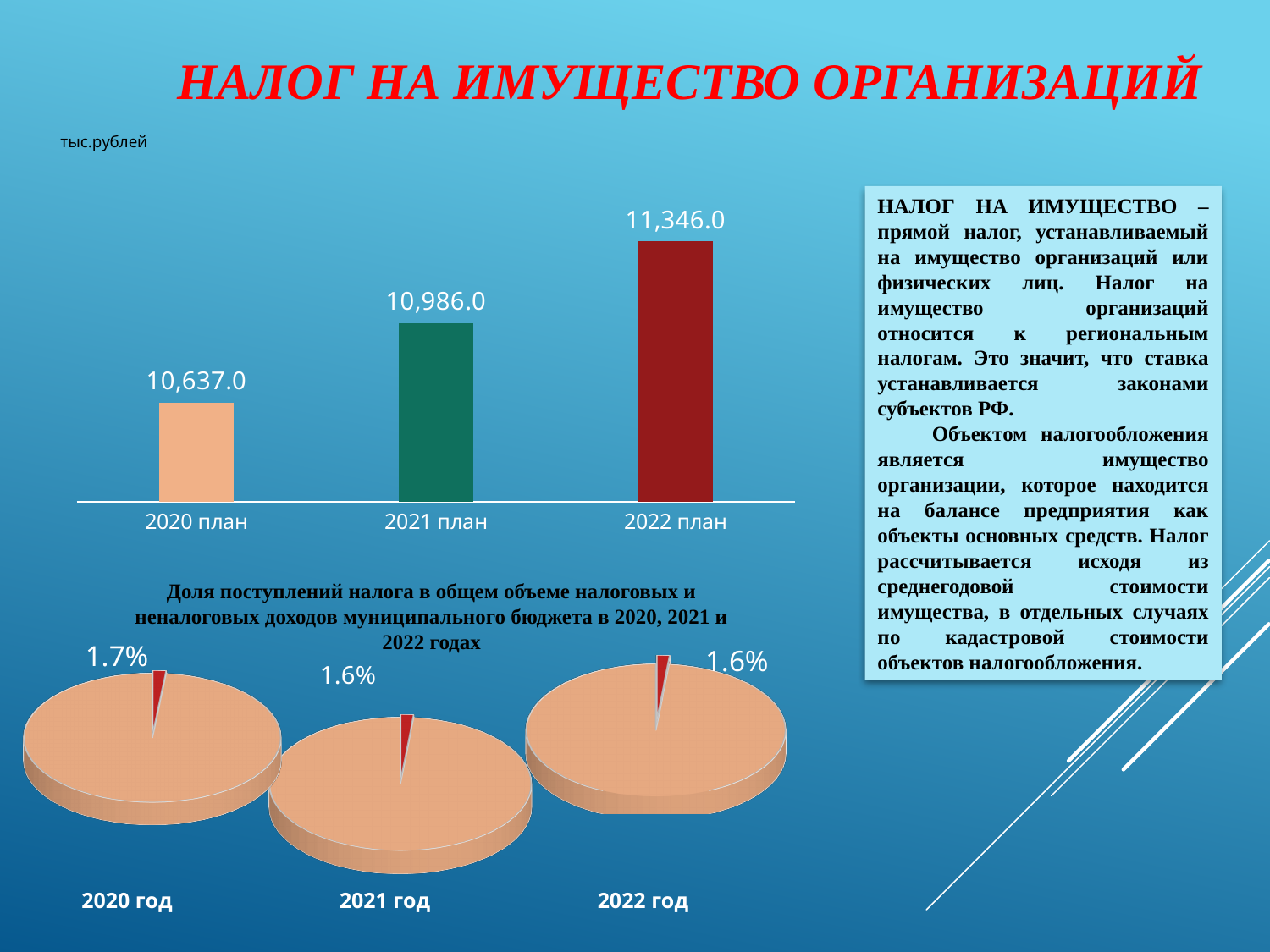
In the bar chart at the top of the slide, what is the value for 2021 план? 10,986.0 How many bars are shown in the bar chart at the top of the slide? 3 In the bar chart at the top of the slide, which is larger: the value for 2021 план or 2022 план? 2022 план In the bar chart at the top of the slide, what is the difference between the values for 2021 план and 2020 план? 349.0 In the bar chart at the top of the slide, what is the value for 2020 план? 10,637.0 In the pie charts at the bottom of the slide, what share is shown for 2020 год? 1.7% In the bar chart at the top of the slide, what is the value for 2022 план? 11,346.0 In the bar chart at the top of the slide, which category has the lowest value? 2020 план What unit is stated for the bar chart at the top of the slide? тыс.рублей In the bar chart at the top of the slide, what is the difference between the values for 2022 план and 2020 план? 709.0 Do the values in the bar chart at the top of the slide rise or fall from 2020 план to 2022 план? rise In the bar chart at the top of the slide, which category has the highest value? 2022 план